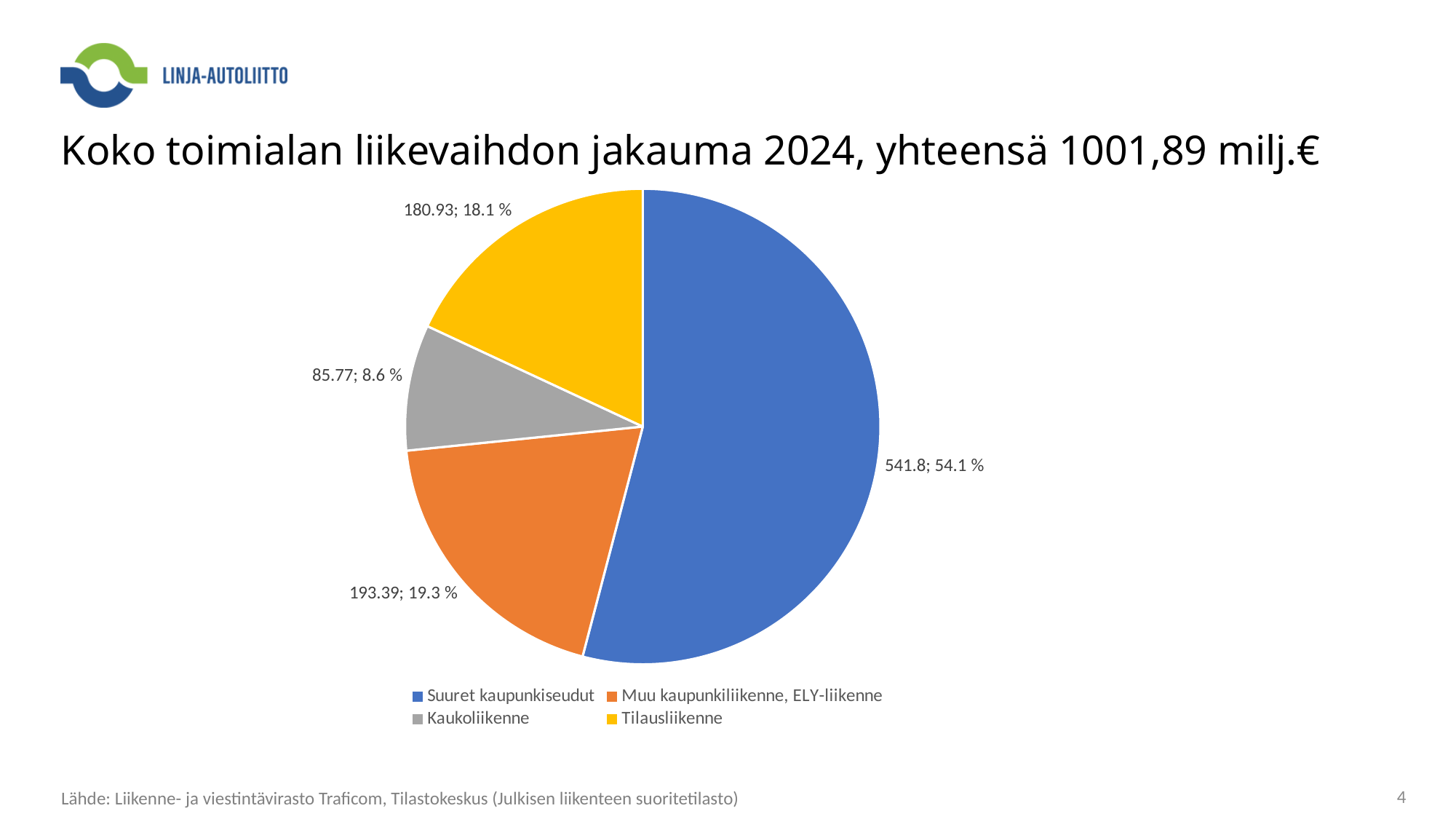
What share of the pie does Suuret kaupunkiseudut represent? 54.1 % What is the difference between the values for Muu kaupunkiliikenne, ELY-liikenne and Tilausliikenne? 12.46 Which colour represents Tilausliikenne in the pie chart? Yellow What is the value for Kaukoliikenne? 85.77 What kind of chart is shown on the slide? Pie chart Which category has the smallest slice? Kaukoliikenne What is the value for Muu kaupunkiliikenne, ELY-liikenne? 193.39 Which category has the largest slice? Suuret kaupunkiseudut What is the value for Tilausliikenne? 180.93 What is the value for Suuret kaupunkiseudut? 541.8 How many categories does the pie chart have? 4 What share of the pie does Kaukoliikenne represent? 8.6 %